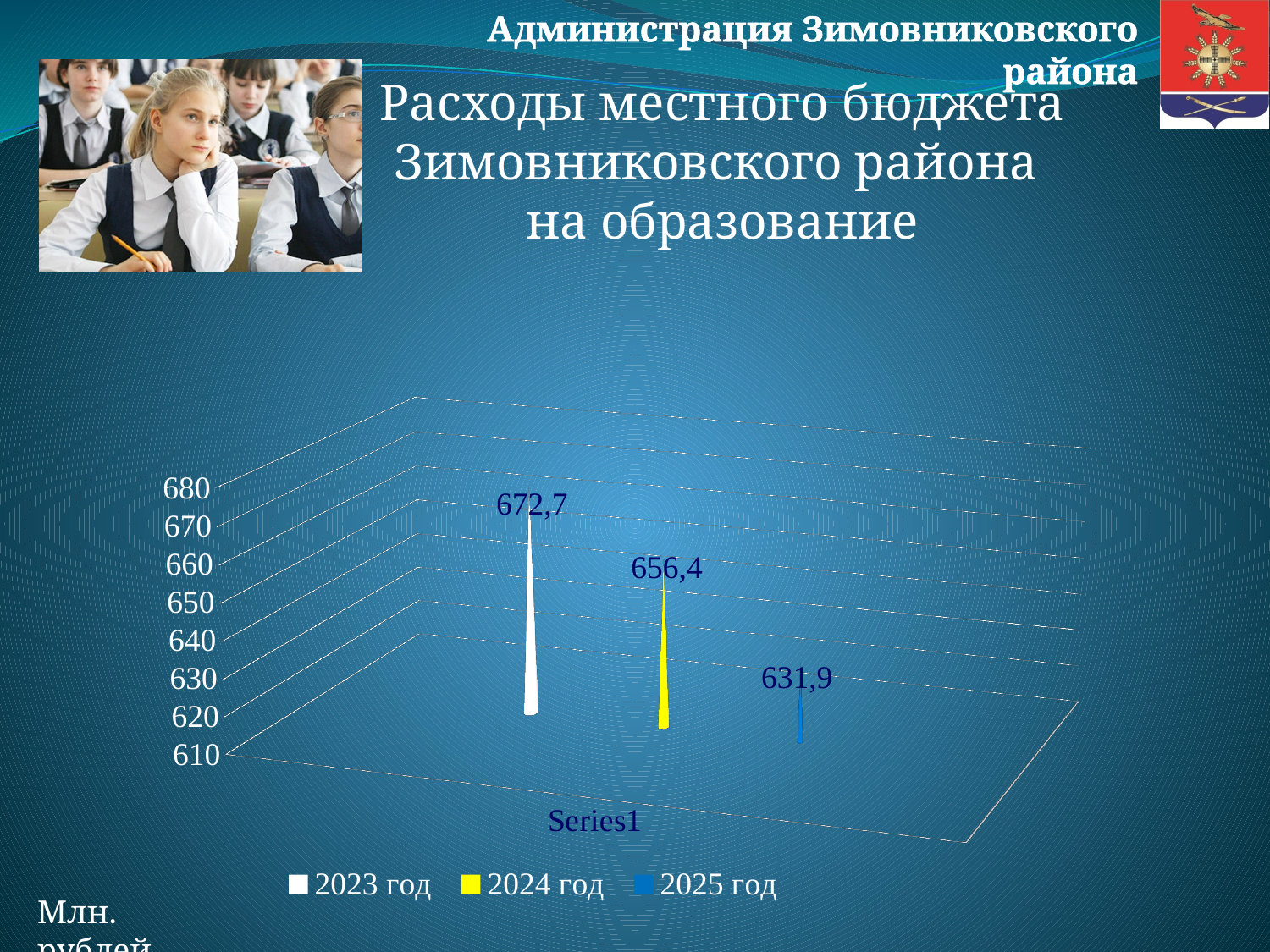
What is the difference between the values for 2023 год and 2024 год? 16,3 How many series does the legend list? 3 What is the value for 2024 год? 656,4 Which year has the lowest value? 2025 год Which year has the highest value? 2023 год What is the value for 2025 год? 631,9 What kind of chart is shown on the slide? bar chart Which is larger, the value for 2024 год or the value for 2025 год? 2024 год Do the values rise or fall from 2023 год to 2025 год? fall What is the difference between the values for 2023 год and 2025 год? 40,8 What colour represents 2024 год in the legend? yellow What is the value for 2023 год? 672,7